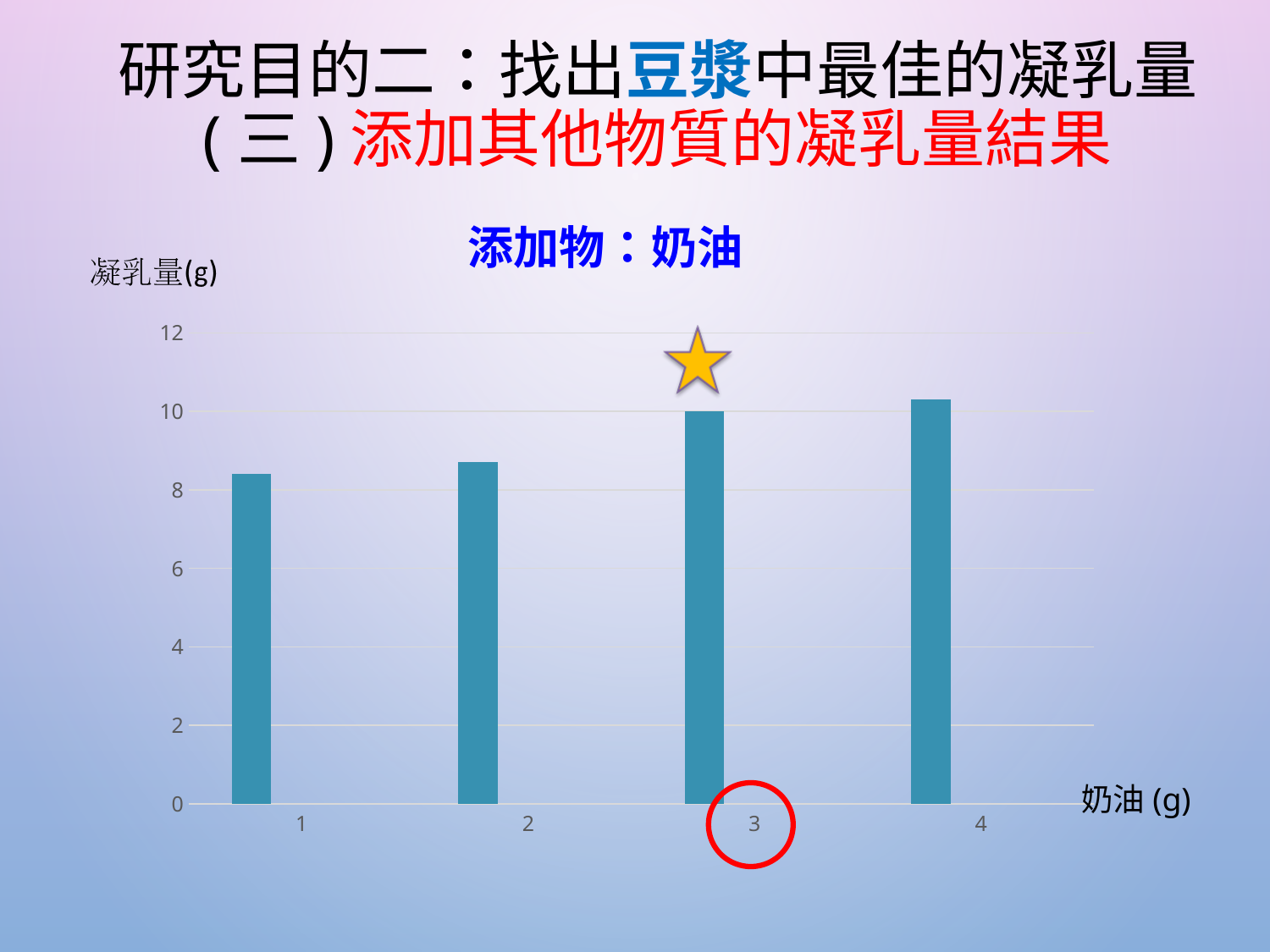
Which category on the x axis is marked with a star and a red circle? 3 Is the value for 奶油 1 g greater or less than 10? less What kind of chart is shown on the slide? bar chart What is the label of the x axis? 奶油 (g) Is the value for 奶油 2 g greater or less than 10? less Which has a larger 凝乳量, 奶油 1 g or 奶油 3 g? 3 How many bars (categories) are plotted in the chart? 4 Is the value for 奶油 4 g greater or less than 8? greater Do the values generally rise or fall as the amount of 奶油 increases from 1 g to 4 g? rise What is the title of the chart? 添加物：奶油 Which has a larger 凝乳量, 奶油 2 g or 奶油 4 g? 4